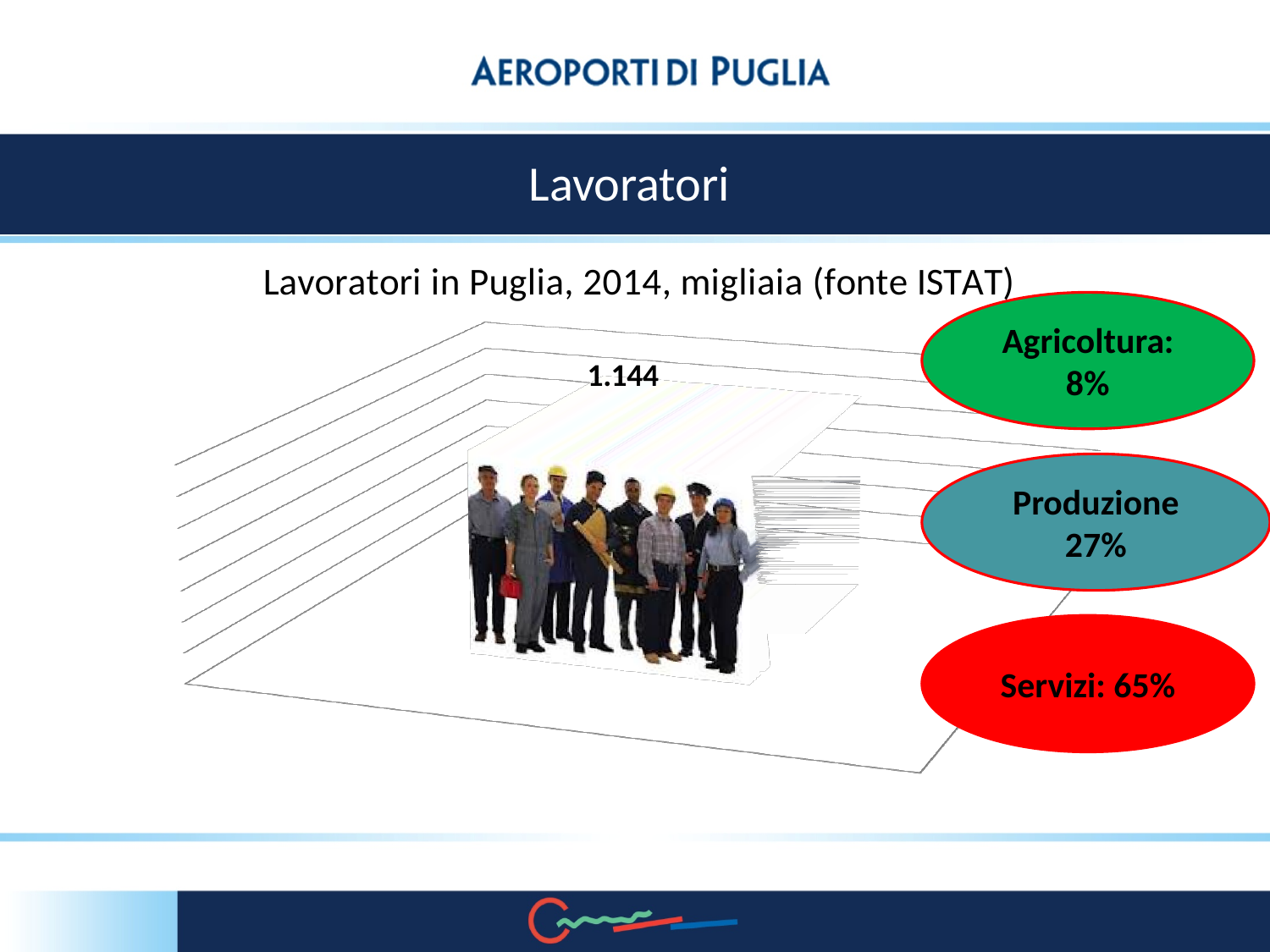
What value is printed on the bar in the chart? 1.144 Which sector shown in the ovals has the highest percentage? Servizi According to the chart title, in what unit are the workers counted? migliaia What percentage is shown for Agricoltura in the oval next to the chart? 8% What is the difference between the Servizi and Produzione percentages shown in the ovals? 38% What percentage is shown for Produzione in the oval next to the chart? 27% Which is larger, the Produzione percentage or the Agricoltura percentage? Produzione What is the title of the chart? Lavoratori in Puglia, 2014, migliaia (fonte ISTAT) Which sector shown in the ovals has the lowest percentage? Agricoltura What percentage is shown for Servizi in the oval next to the chart? 65% How many bars does the chart contain? 1 What kind of chart is shown on the slide? bar chart